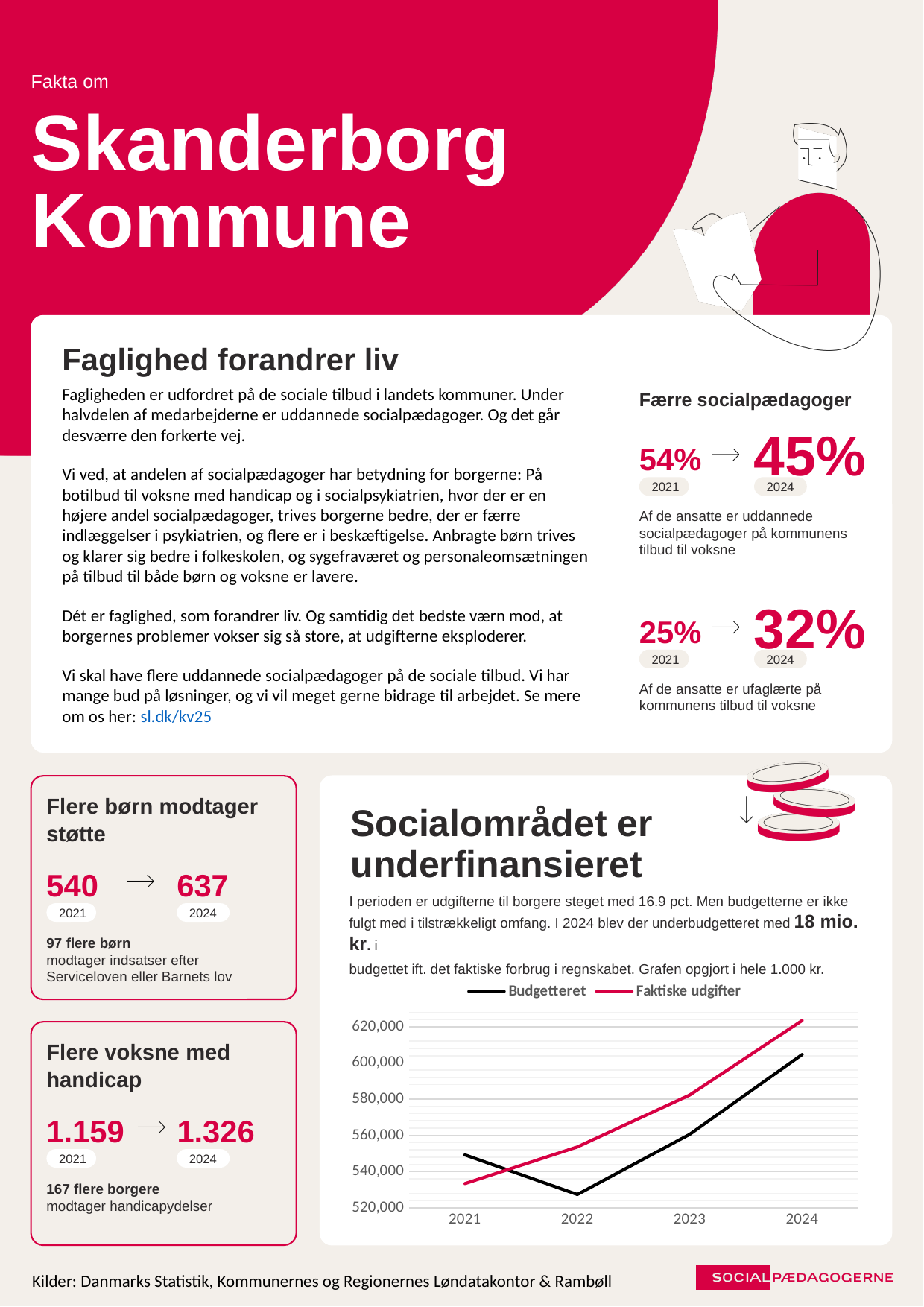
In the line chart, which series is higher in 2024, Budgetteret or Faktiske udgifter? Faktiske udgifter In the line chart, which year has the lowest Budgetteret value? 2022 In the line chart, what colour is the Faktiske udgifter line? red In the line chart, which series is higher in 2021, Budgetteret or Faktiske udgifter? Budgetteret How many years are plotted along the x axis of the line chart? 4 In the line chart, is the Faktiske udgifter value for 2023 greater or less than 560,000? greater In the line chart, do the Faktiske udgifter values rise or fall from 2021 to 2024? rise How many series does the legend of the line chart list? 2 In the line chart, is the Faktiske udgifter value for 2024 greater or less than 600,000? greater In the line chart, is the Budgetteret value for 2022 greater or less than 540,000? less What kind of chart is shown under the heading 'Socialområdet er underfinansieret'? line chart